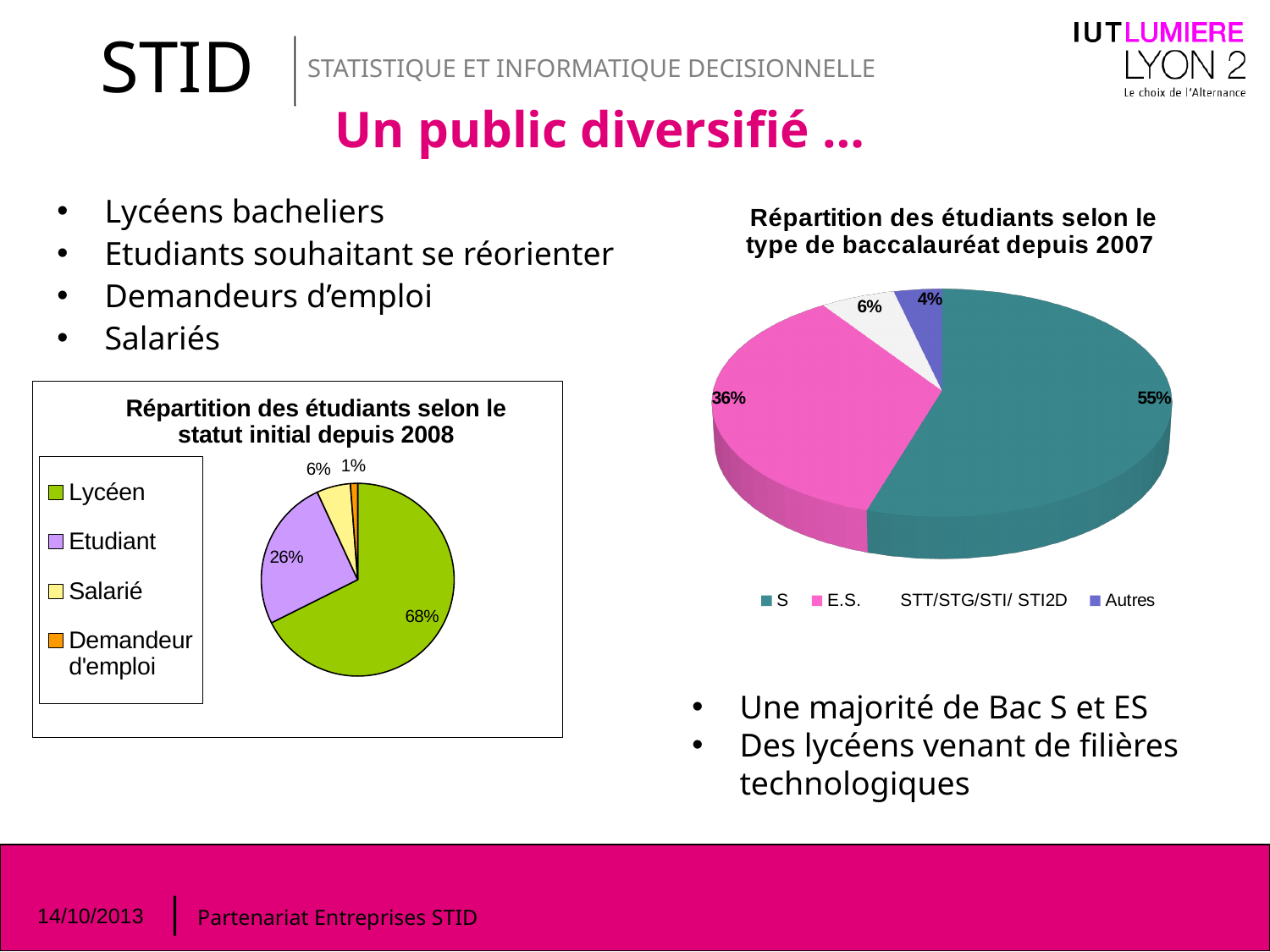
In the chart 'Répartition des étudiants selon le statut initial depuis 2008', what share is Lycéen? 68% In the chart 'Répartition des étudiants selon le statut initial depuis 2008', how many categories does the legend list? 4 In the chart 'Répartition des étudiants selon le type de baccalauréat depuis 2007', which category has the largest share? S What kind of chart is 'Répartition des étudiants selon le type de baccalauréat depuis 2007'? Pie chart In the chart 'Répartition des étudiants selon le type de baccalauréat depuis 2007', what share is S? 55% In the chart 'Répartition des étudiants selon le type de baccalauréat depuis 2007', what is the difference between the S and E.S. shares? 19% In the chart 'Répartition des étudiants selon le type de baccalauréat depuis 2007', which is larger, STT/STG/STI/STI2D or Autres? STT/STG/STI/STI2D In the chart 'Répartition des étudiants selon le type de baccalauréat depuis 2007', what colour is the S slice? Teal In the chart 'Répartition des étudiants selon le statut initial depuis 2008', which category has the smallest share? Demandeur d'emploi In the chart 'Répartition des étudiants selon le statut initial depuis 2008', what share is Etudiant? 26% In the chart 'Répartition des étudiants selon le statut initial depuis 2008', what is the difference between the Lycéen and Etudiant shares? 42%